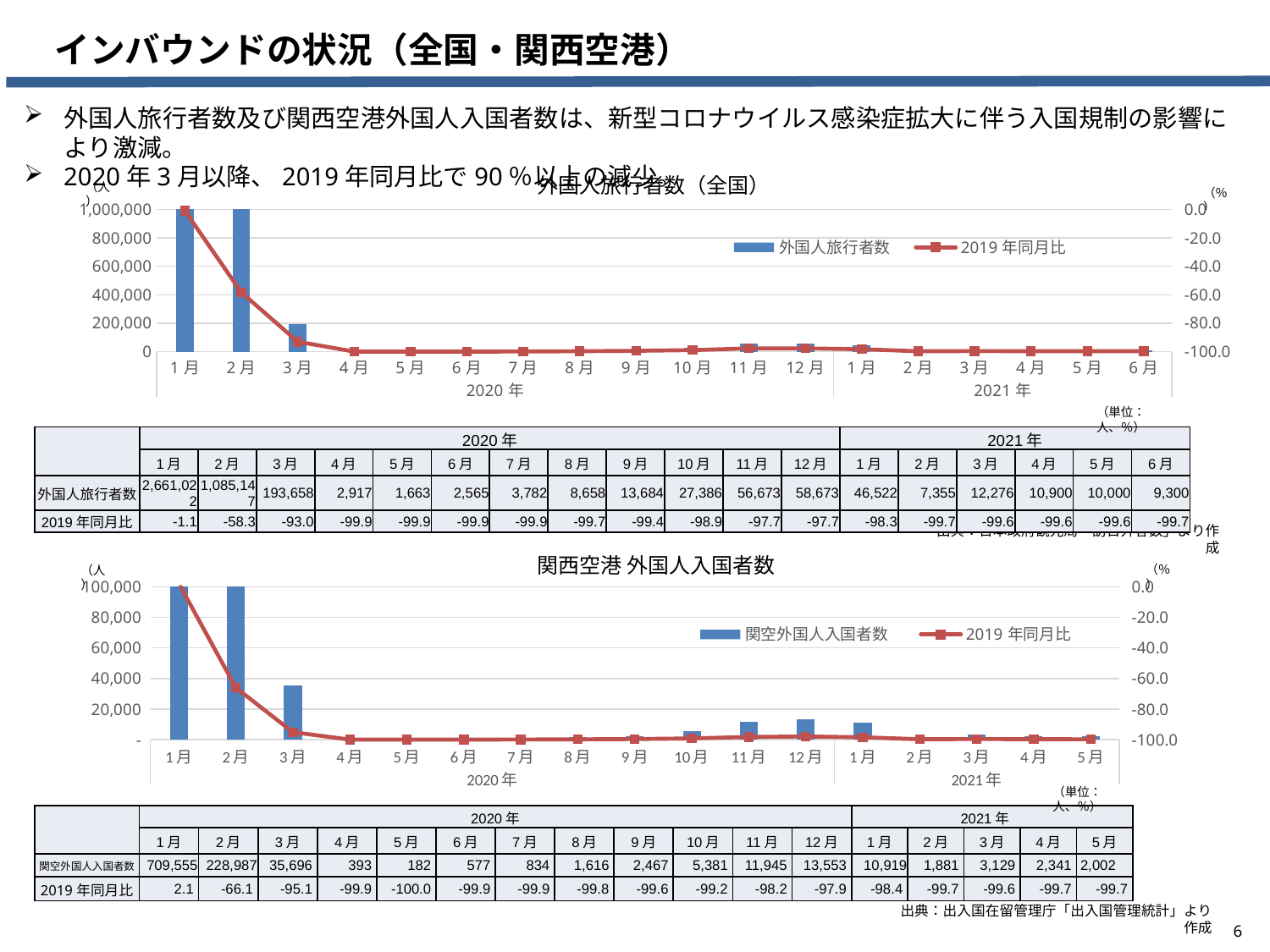
In the top chart 外国人旅行者数（全国）, what is the 2019年同月比 value for 2020年4月? -99.9 In the bottom chart 関西空港 外国人入国者数, which is larger, the 関空外国人入国者数 for 2020年12月 or for 2021年1月? 2020年12月 How many months are plotted on the x axis of the bottom chart 関西空港 外国人入国者数? 17 In the bottom chart 関西空港 外国人入国者数, what is the 2019年同月比 value for 2020年5月? -100.0 In the top chart 外国人旅行者数（全国）, which month has the lowest 外国人旅行者数? 2020年5月 In the bottom chart 関西空港 外国人入国者数, do the 関空外国人入国者数 bars rise or fall from 2020年1月 to 2020年4月? Fall In the bottom chart 関西空港 外国人入国者数, what is the 関空外国人入国者数 value for 2020年1月? 709,555 How many months are plotted on the x axis of the top chart 外国人旅行者数（全国）? 18 In the top chart 外国人旅行者数（全国）, what is the 外国人旅行者数 value for 2020年3月? 193,658 How many series does the legend of the top chart 外国人旅行者数（全国） list? 2 In the top chart 外国人旅行者数（全国）, what is the difference in 外国人旅行者数 between 2020年12月 and 2020年11月? 2,000 What kind of chart is the top chart titled 外国人旅行者数（全国）? A combination bar and line chart